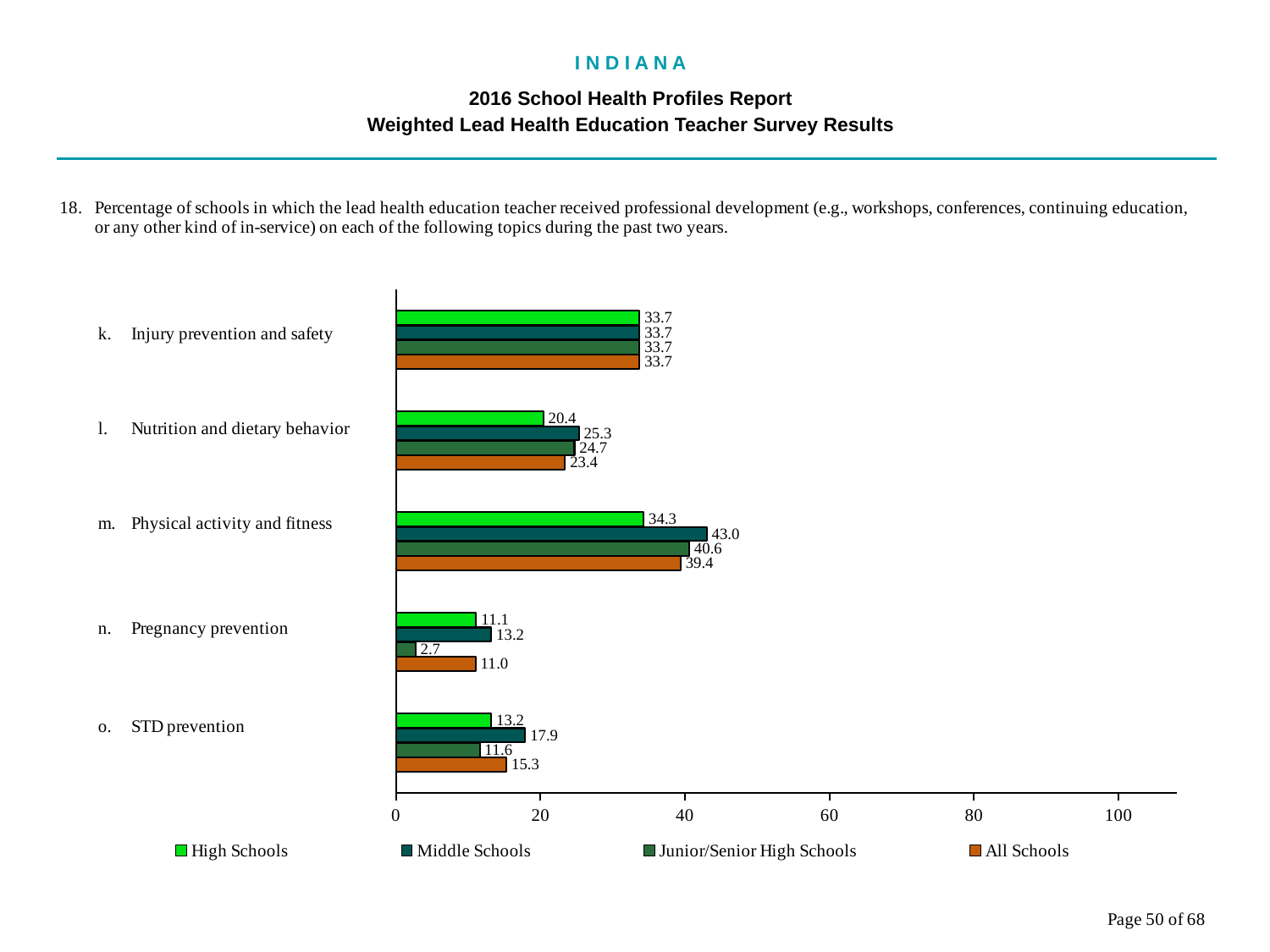
What is the value for High Schools for Nutrition and dietary behavior? 20.4 Is the value for Middle Schools for Physical activity and fitness greater or less than 40? greater Which topic has the lowest value for Junior/Senior High Schools? Pregnancy prevention What is the value for All Schools for STD prevention? 15.3 How many topics are shown on the chart? 5 Which topic has the highest value for All Schools? Physical activity and fitness What is the value for Middle Schools for Physical activity and fitness? 43.0 What is the value for Junior/Senior High Schools for Pregnancy prevention? 2.7 What is the difference between the Middle Schools and High Schools values for Physical activity and fitness? 8.7 Which is larger for STD prevention: the Middle Schools value or the All Schools value? Middle Schools What kind of chart is shown on the slide? Bar chart How many series does the legend list? 4